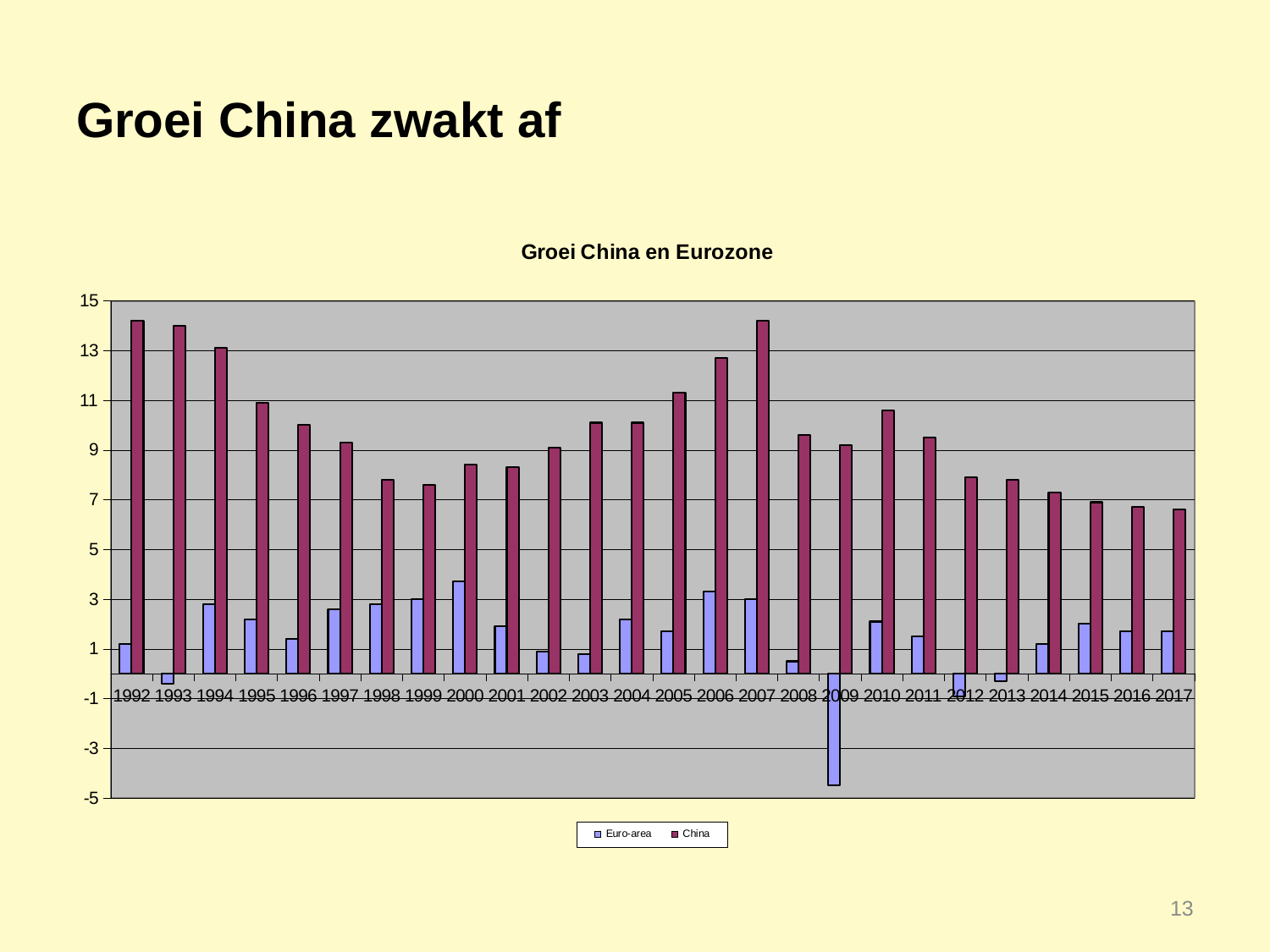
What is the title of the chart? Groei China en Eurozone What kind of chart is shown on the slide? bar chart Which is larger, the China value for 2007 or the China value for 2008? 2007 Is the Euro-area value for 2009 greater or less than -3? less Do the China values rise or fall from 2010 to 2017? fall Which two series are listed in the legend? Euro-area and China How many series does the legend list? 2 How many years are shown on the x axis? 26 Is the China value for 2017 greater or less than 7? less Is the China value for 1998 greater or less than 9? less In which year is the Euro-area value lowest? 2009